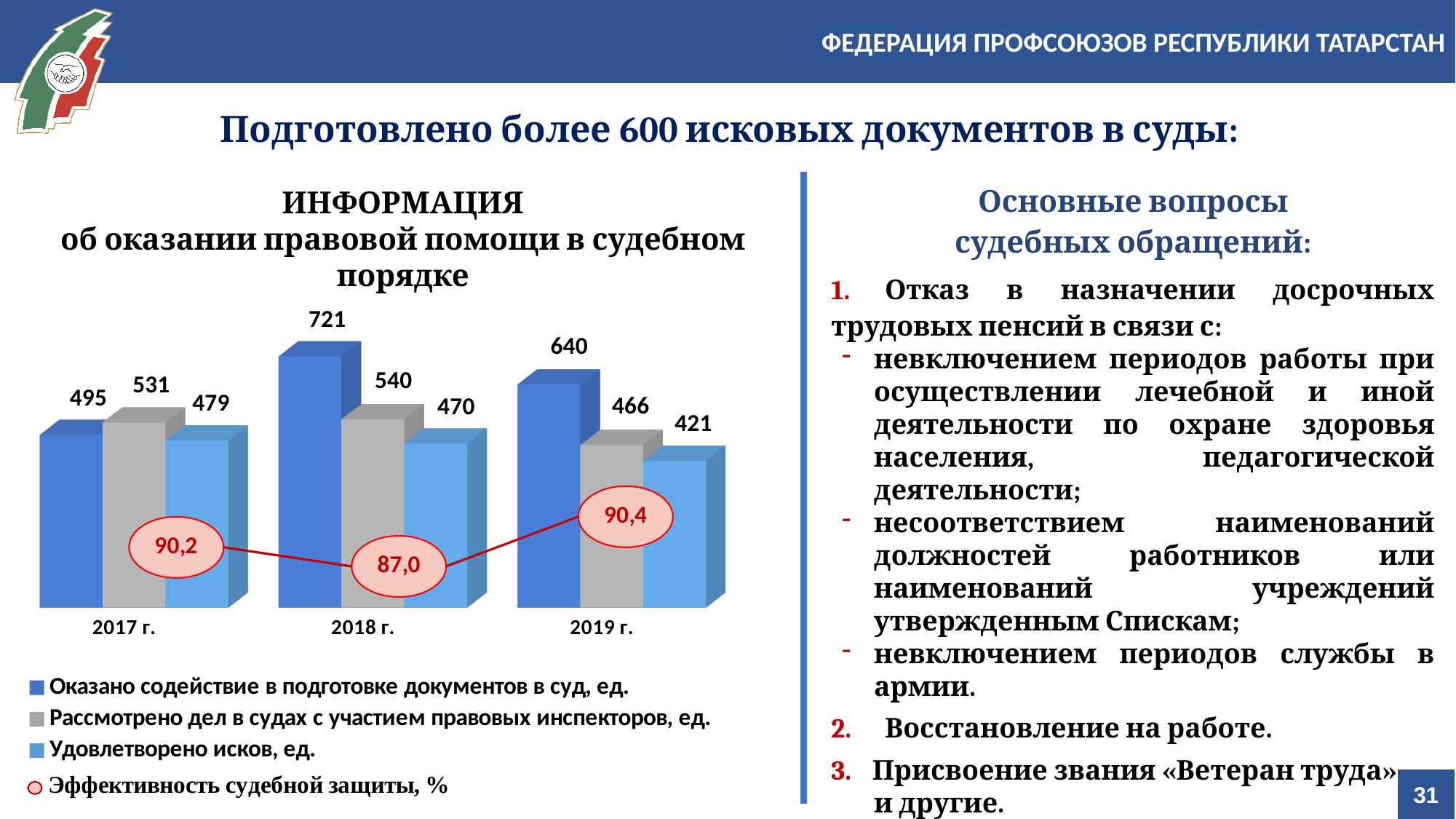
Does "Удовлетворено исков, ед." rise or fall from 2017 г. to 2019 г.? Fall What is the difference between "Оказано содействие в подготовке документов в суд, ед." in 2018 г. and 2019 г.? 81 What is the value for "Удовлетворено исков, ед." in 2019 г.? 421 How many years are shown on the x axis of the chart? 3 How many series does the chart legend list? 4 What is the value of "Эффективность судебной защиты, %" in 2018 г.? 87,0 What kind of chart is shown on the slide? Bar chart Which is larger in 2017 г.: "Оказано содействие в подготовке документов в суд, ед." or "Рассмотрено дел в судах с участием правовых инспекторов, ед."? Рассмотрено дел в судах с участием правовых инспекторов, ед. What is the value for "Рассмотрено дел в судах с участием правовых инспекторов, ед." in 2017 г.? 531 In which year is "Удовлетворено исков, ед." lowest? 2019 г. In which year is "Оказано содействие в подготовке документов в суд, ед." highest? 2018 г. What is the value for "Оказано содействие в подготовке документов в суд, ед." in 2018 г.? 721